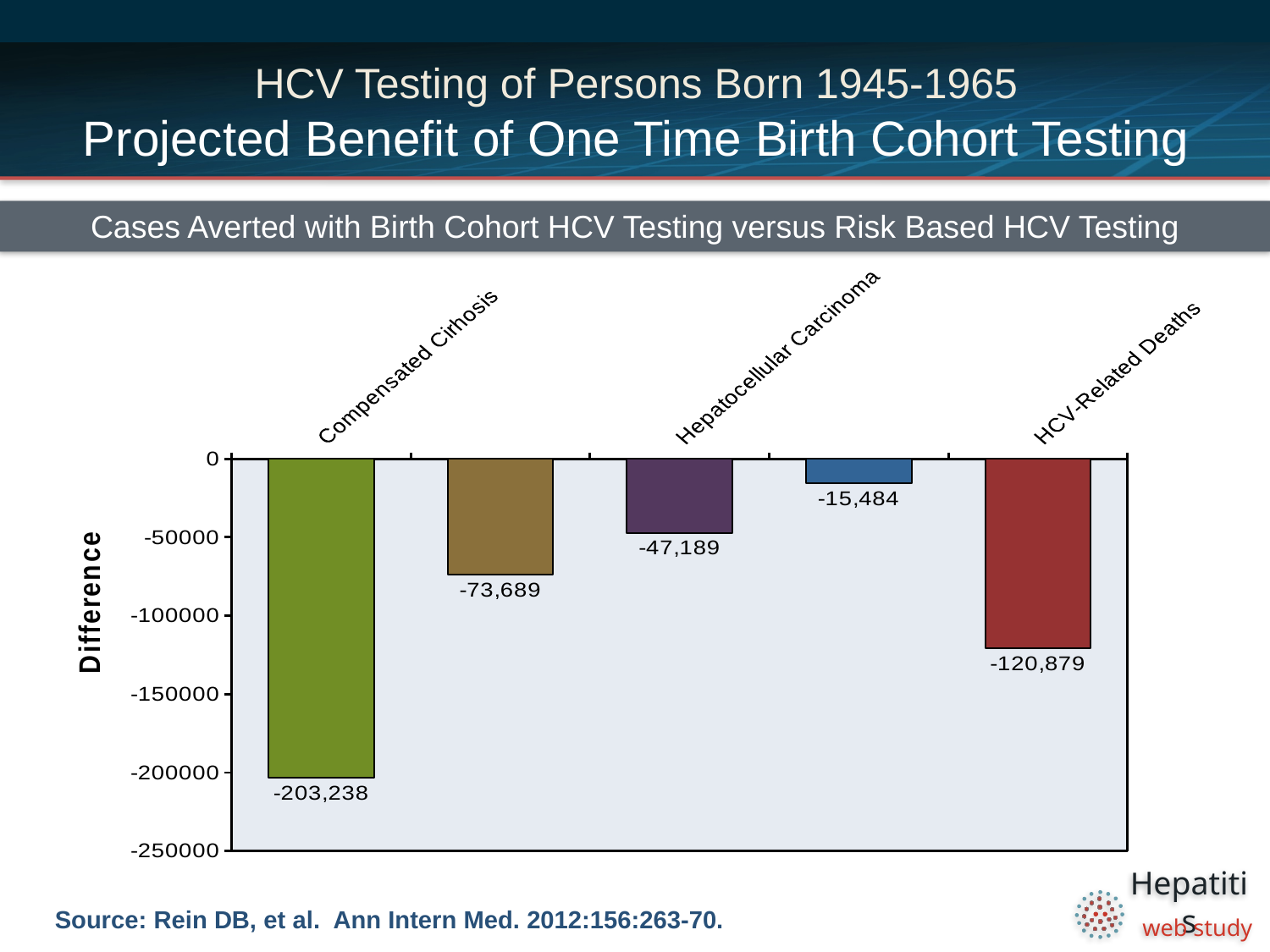
By how much does the magnitude of the Compensated Cirrhosis value exceed that of HCV-Related Deaths? 82,359 What is the value labelled on the second bar from the left? -73,689 Which category has the lowest (most negative) value on the chart? Compensated Cirrhosis What kind of chart is shown on the slide? Bar chart What is the value shown for Compensated Cirrhosis? -203,238 Which has the larger magnitude of difference: Hepatocellular Carcinoma or HCV-Related Deaths? HCV-Related Deaths How many bars are plotted on the chart? 5 What is the label on the vertical axis of the chart? Difference What is the value shown for HCV-Related Deaths? -120,879 What is the difference in magnitude between the HCV-Related Deaths value and the Hepatocellular Carcinoma value? 73,690 What is the value shown for Hepatocellular Carcinoma? -47,189 Is the value for HCV-Related Deaths greater or less than -100000? less